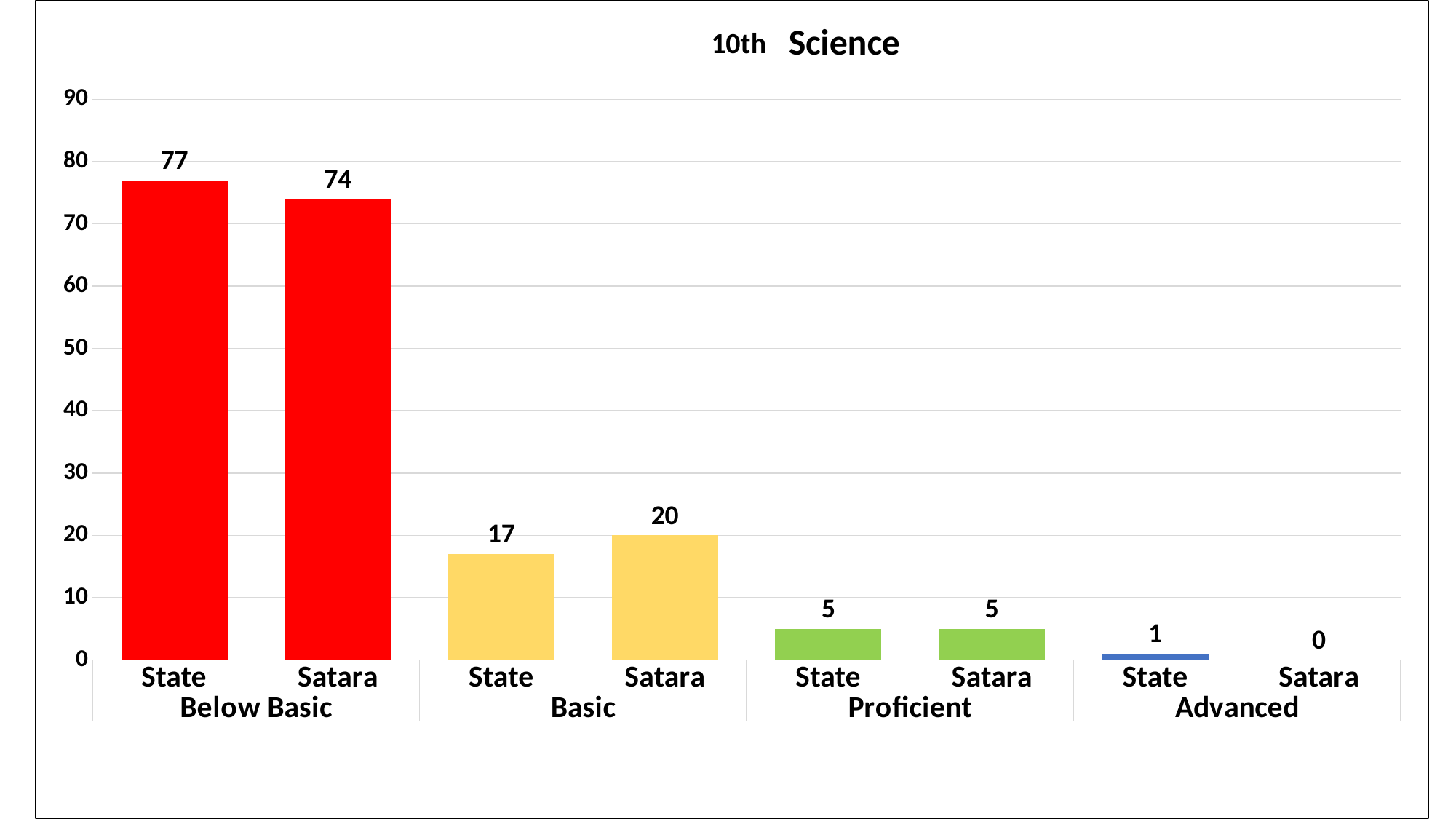
Which bar has the highest value? State, Below Basic What is the difference between the State and Satara values under Below Basic? 3 Is the value for Satara under Below Basic greater or less than 70? greater What is the value for State under Proficient? 5 What is the title of the chart? 10th Science What is the value for Satara under Basic? 20 What is the value for Satara under Advanced? 0 What kind of chart is shown? bar chart Which is larger, the State value or the Satara value under Basic? Satara What is the value for State under Below Basic? 77 How many bars are plotted on the chart? 8 Which bar has the lowest value? Satara, Advanced